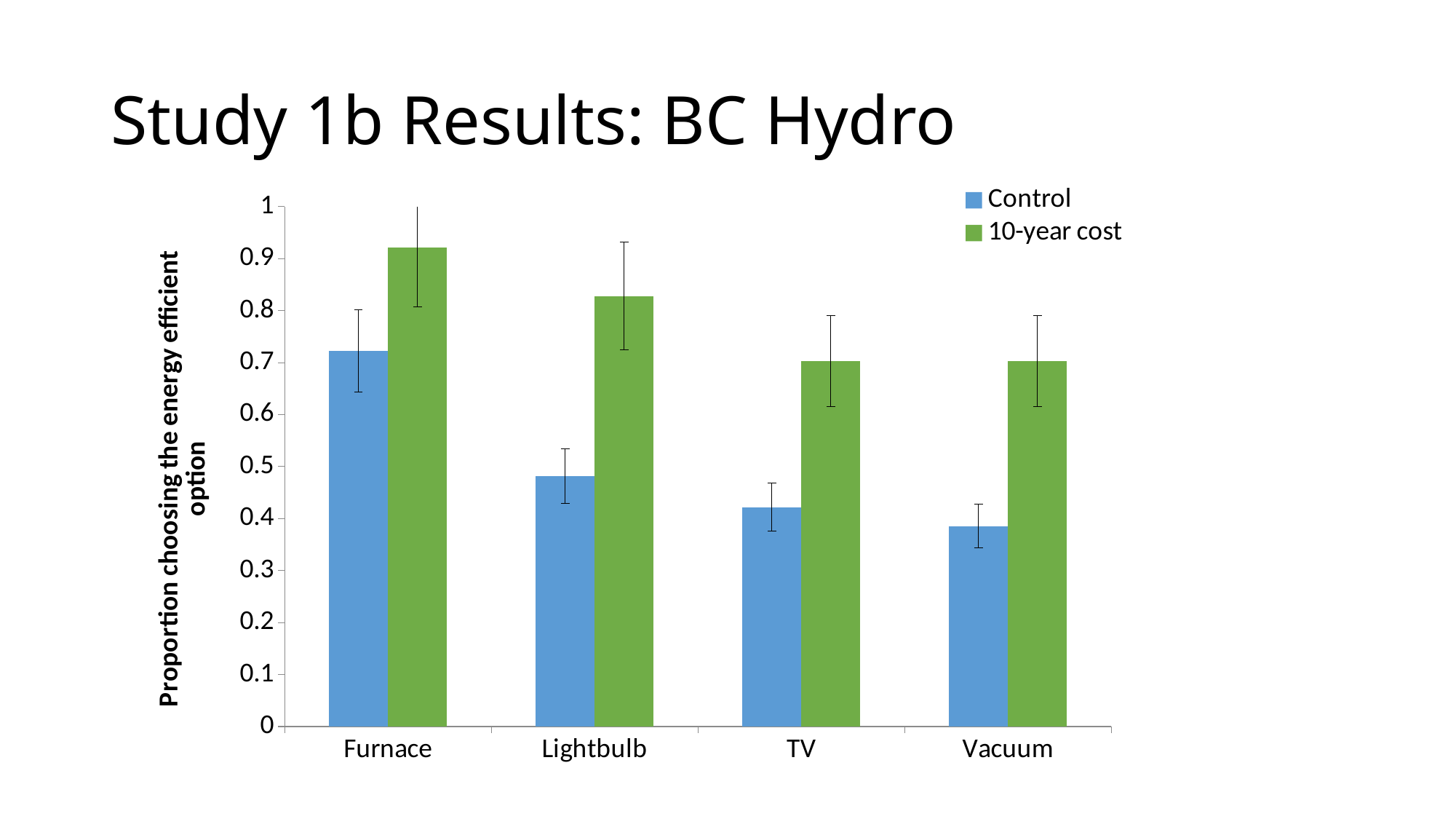
What is the label on the y axis? Proportion choosing the energy efficient option How many product categories are shown on the x axis? 4 Is the 10-year cost value for Lightbulb greater or less than 0.8? greater Which category has the highest Control bar? Furnace Which category has the highest 10-year cost bar? Furnace How many series does the legend list? 2 Is the 10-year cost value for TV greater or less than 0.6? greater Is the Control value for Furnace greater or less than 0.6? greater What kind of chart is shown on the slide? Bar chart Do the Control values rise or fall from Furnace to Vacuum along the x axis? fall Which is larger, the Control value for Furnace or the Control value for Lightbulb? Furnace